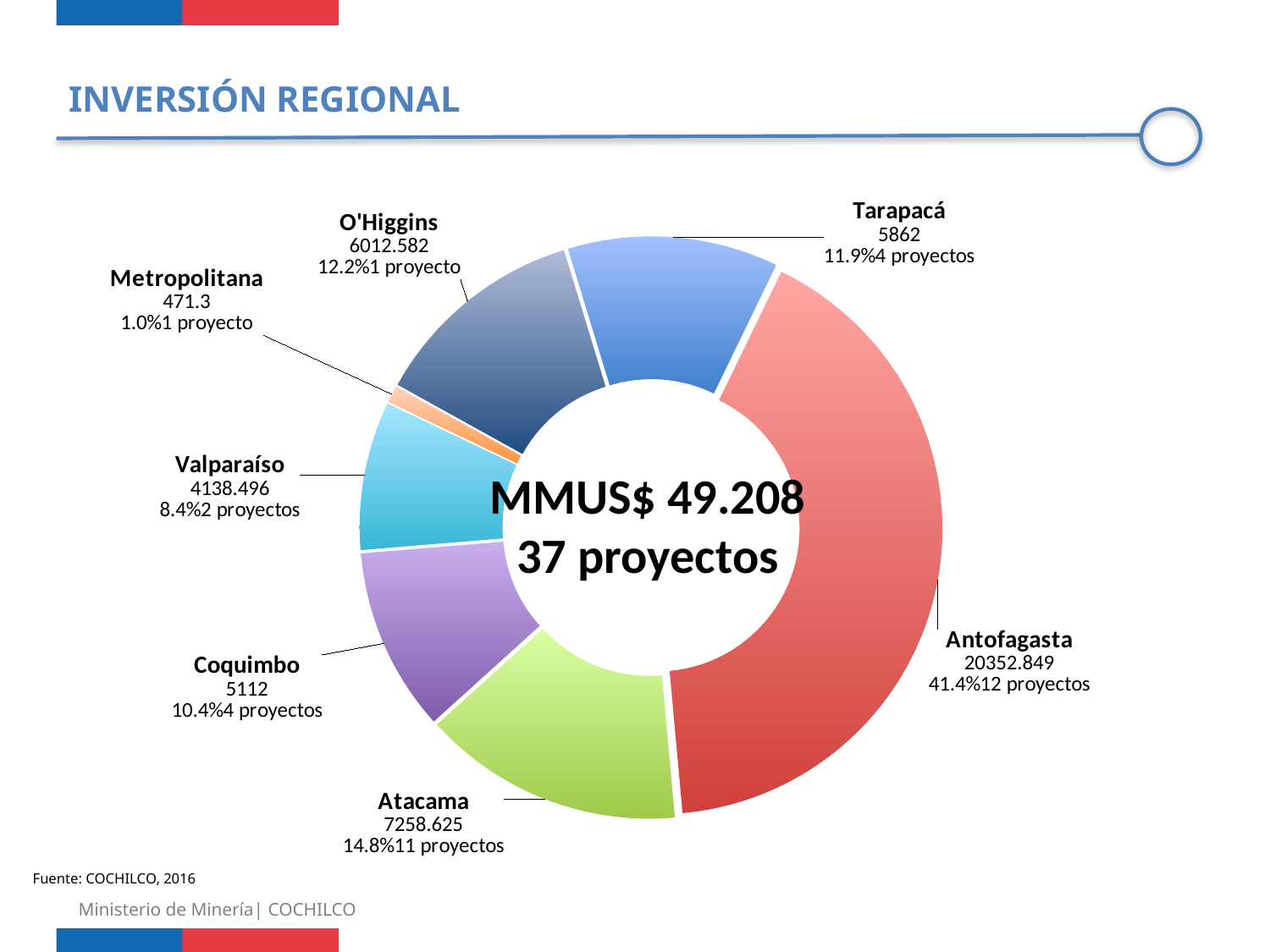
What is the investment value shown for Antofagasta? 20352.849 What is the investment value shown for Atacama? 7258.625 What percentage share does Tarapacá have? 11.9% What kind of chart is shown on the slide? Doughnut (pie) chart Which has a larger investment value, Coquimbo or Tarapacá? Tarapacá What is the investment value shown for Valparaíso? 4138.496 How many regions are shown in the chart? 7 What total is shown in the centre of the chart? MMUS$ 49.208, 37 proyectos Which region has the largest share of the chart? Antofagasta How many projects are listed for Atacama? 11 proyectos Which region has the smallest share of the chart? Metropolitana What percentage share does O'Higgins have? 12.2%